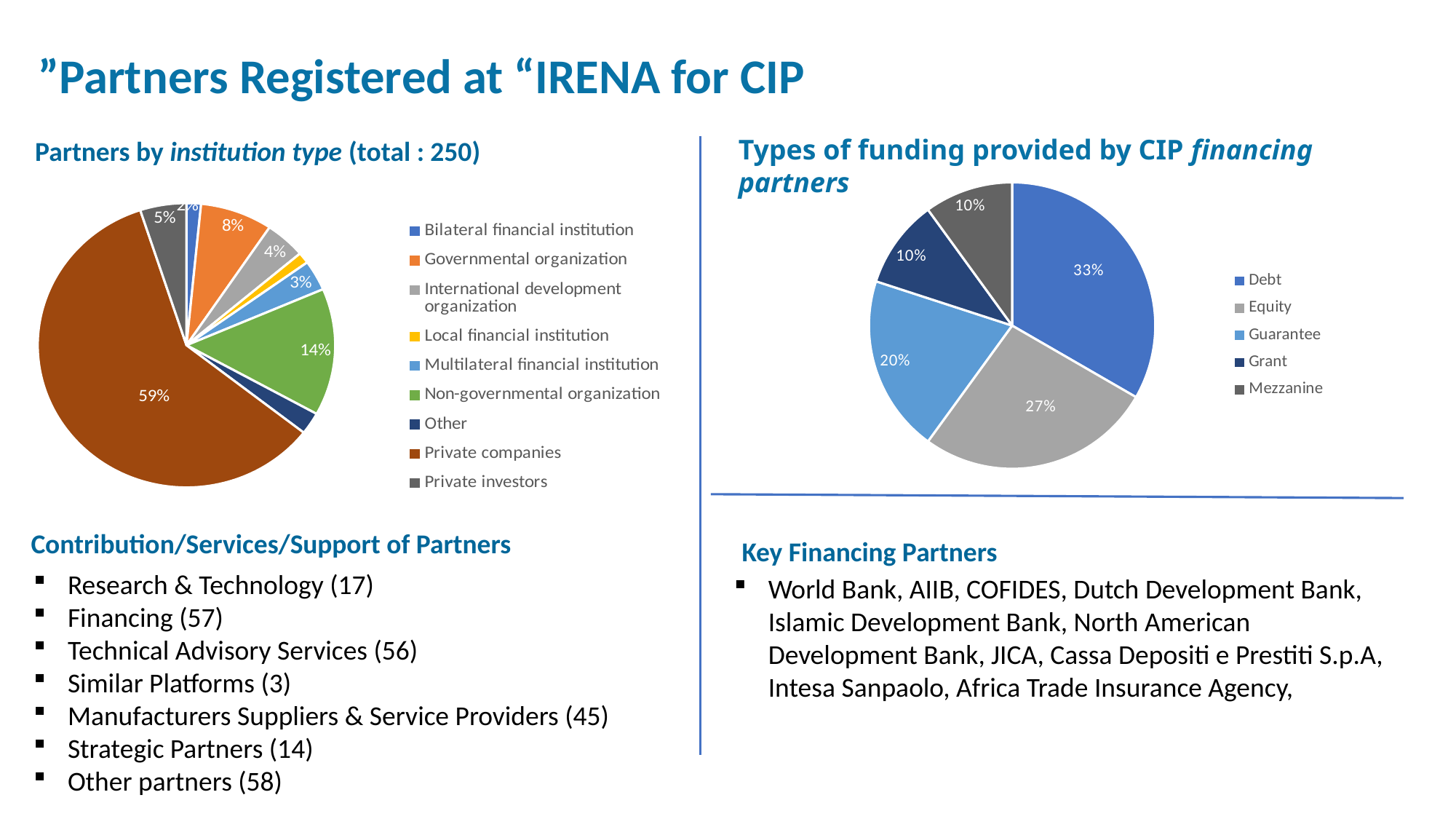
In the 'Partners by institution type' pie chart, what share do Private companies have? 59% In the 'Types of funding provided by CIP financing partners' pie chart, what is the difference between the Debt and Guarantee shares? 13% In the 'Types of funding provided by CIP financing partners' pie chart, what share does Equity have? 27% In the 'Types of funding provided by CIP financing partners' pie chart, how many funding types are shown? 5 In the 'Partners by institution type' pie chart, which institution type has the largest share? Private companies In the 'Partners by institution type' pie chart, which is larger: Private investors or Governmental organization? Governmental organization What type of chart is used for 'Types of funding provided by CIP financing partners'? Pie chart In the 'Partners by institution type' pie chart, what share do Governmental organizations have? 8% In the 'Partners by institution type' pie chart, what share do Non-governmental organizations have? 14% In the 'Types of funding provided by CIP financing partners' pie chart, which funding type has the largest share? Debt In the 'Types of funding provided by CIP financing partners' pie chart, what share does Debt have? 33% In the 'Partners by institution type' pie chart, how many institution types does the legend list? 9